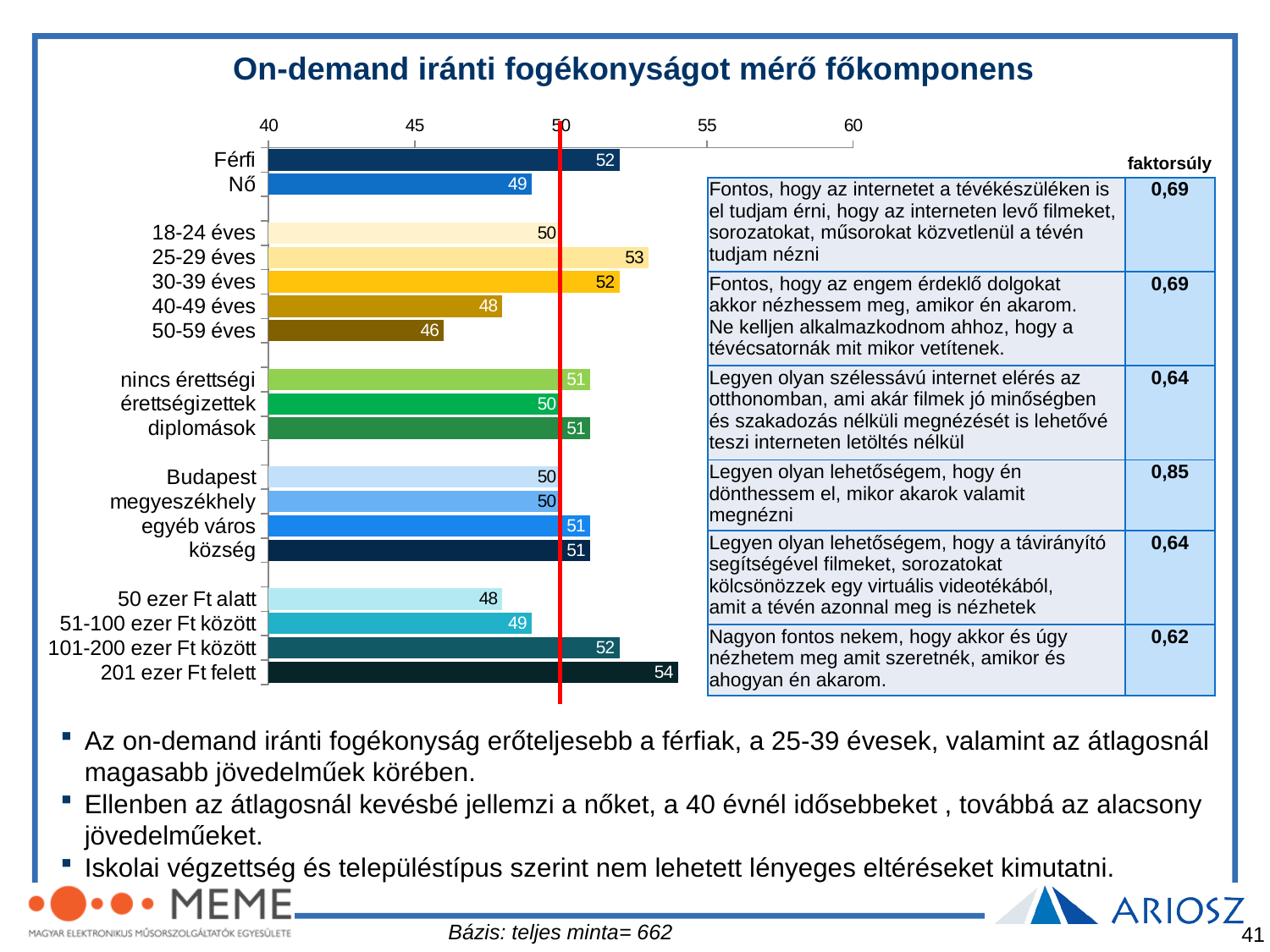
What is the value for 201 ezer Ft felett? 54 Which category has the lowest value? 50-59 éves What is the difference between the values for Férfi and Nő? 3 What kind of chart is shown on the slide? bar chart What is the value for 25-29 éves? 53 What is the value for Férfi? 52 What is the title of the chart? On-demand iránti fogékonyságot mérő főkomponens How many categories are plotted in the chart? 18 What is the value for 50-59 éves? 46 What is the difference between the values for 201 ezer Ft felett and 50 ezer Ft alatt? 6 Which is larger, the value for 25-29 éves or the value for 40-49 éves? 25-29 éves Which category has the highest value? 201 ezer Ft felett